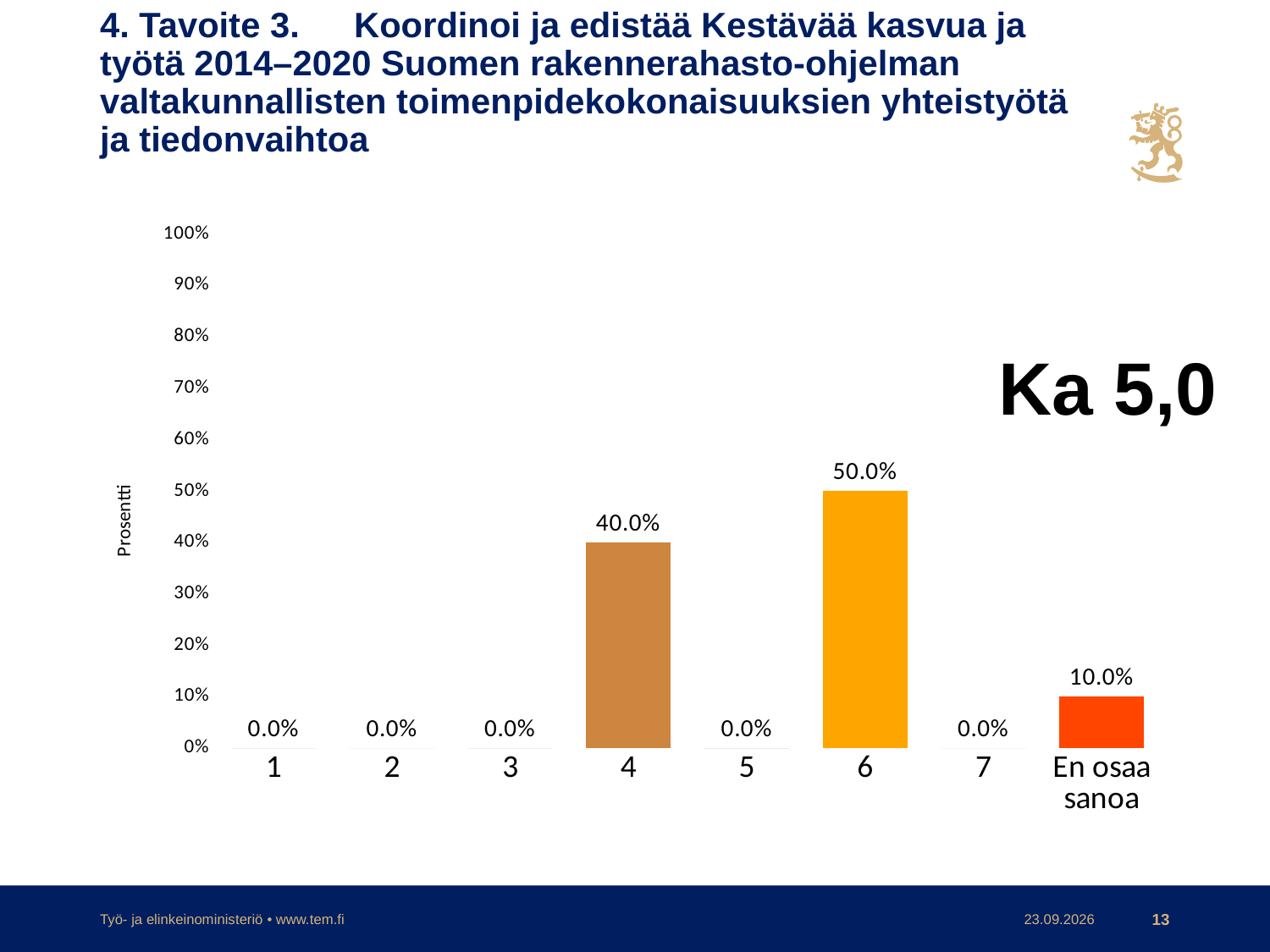
What is the value for category 4? 40.0% What is the difference between the values for category 4 and 'En osaa sanoa'? 30.0% How many categories are shown on the x axis? 8 What is the value for 'En osaa sanoa'? 10.0% What is the label of the y axis? Prosentti What is the value for category 1? 0.0% What is the difference between the values for category 6 and category 4? 10.0% What kind of chart is shown on the slide? bar chart What average value (Ka) is printed next to the chart? Ka 5,0 Which category has the highest value? 6 What is the value for category 6? 50.0% Which is larger, the value for category 4 or the value for 'En osaa sanoa'? 4